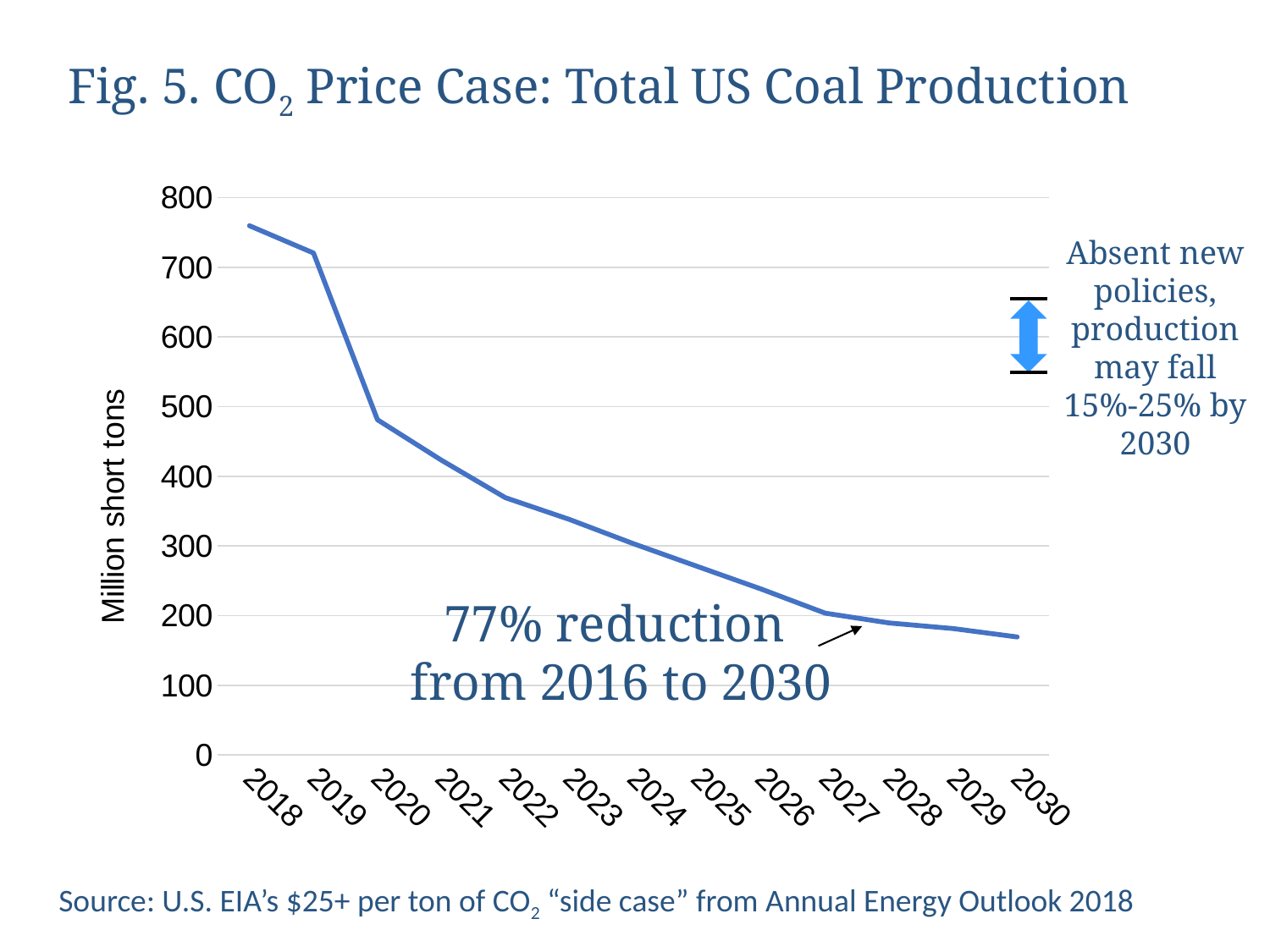
Is the value for 2018 greater or less than 700? greater What is the label on the y axis? Million short tons What percentage reduction from 2016 to 2030 does the annotation on the chart state? 77% What kind of chart is shown on the slide? line chart Is the value for 2022 greater or less than 400? less Which year has the highest total US coal production? 2018 Is the value for 2026 greater or less than 200? greater Which is larger, the value for 2020 or the value for 2025? 2020 Which year has the lowest total US coal production? 2030 How many years are plotted along the x axis? 13 Do the values rise or fall from 2018 to 2030? fall